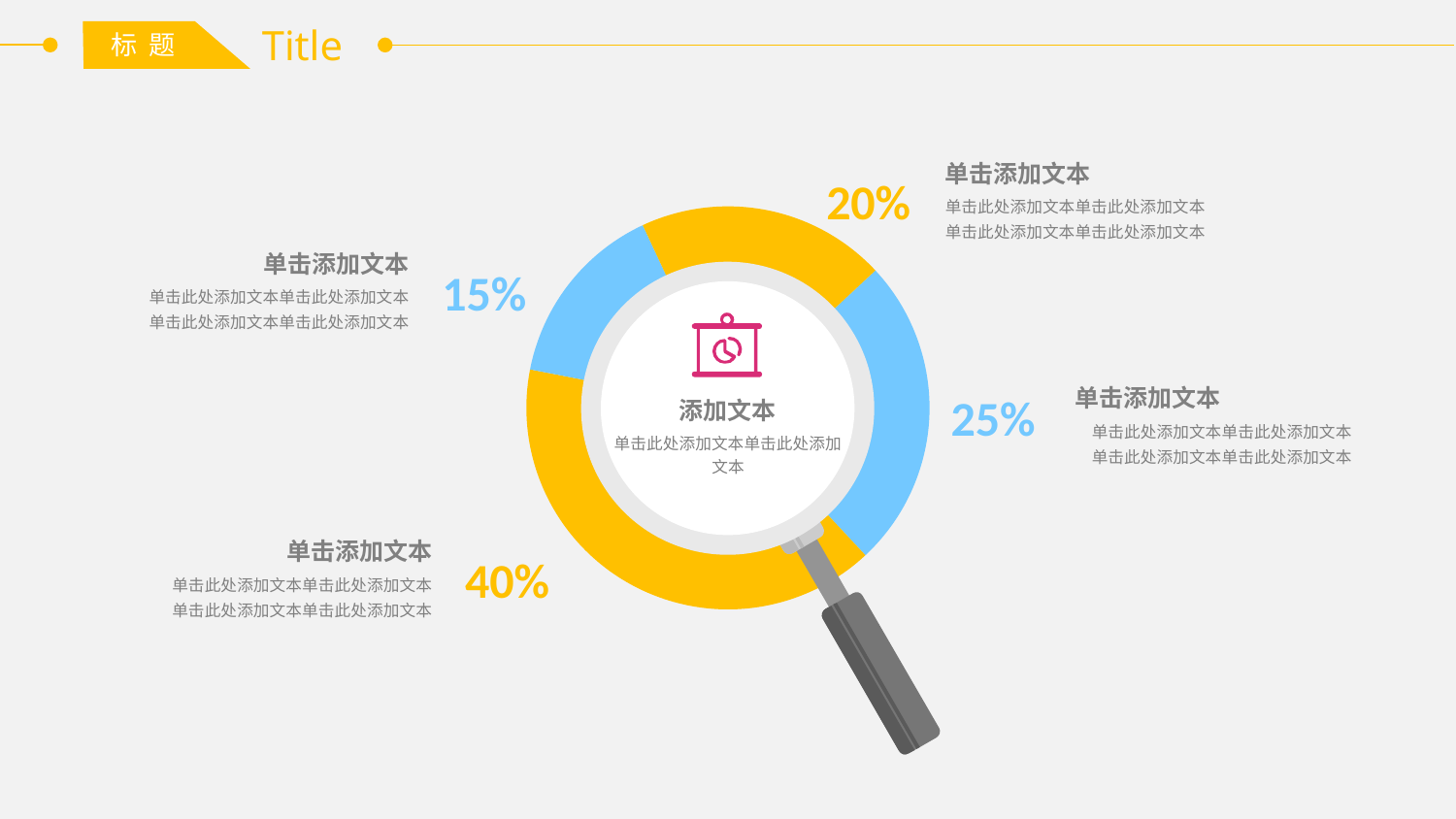
What percentage is labelled on the blue segment on the left side of the donut chart? 15% What is the smallest percentage shown on the donut chart? 15% What kind of chart is shown on the slide? pie chart (donut) What do the four segment percentages of the donut chart add up to? 100% What percentage is labelled on the blue segment on the right side of the donut chart? 25% What percentage is labelled on the yellow segment at the top of the donut chart? 20% What is the difference between the largest segment (40%) and the smallest segment (15%)? 25% What is the largest percentage shown on the donut chart? 40% What percentage is labelled on the large yellow segment at the bottom-left of the donut chart? 40% Which is larger: the blue segment on the right (25%) or the yellow segment at the top (20%)? the blue segment on the right (25%) Which two colours are used for the segments of the donut chart? yellow and blue How many segments does the donut chart have? 4